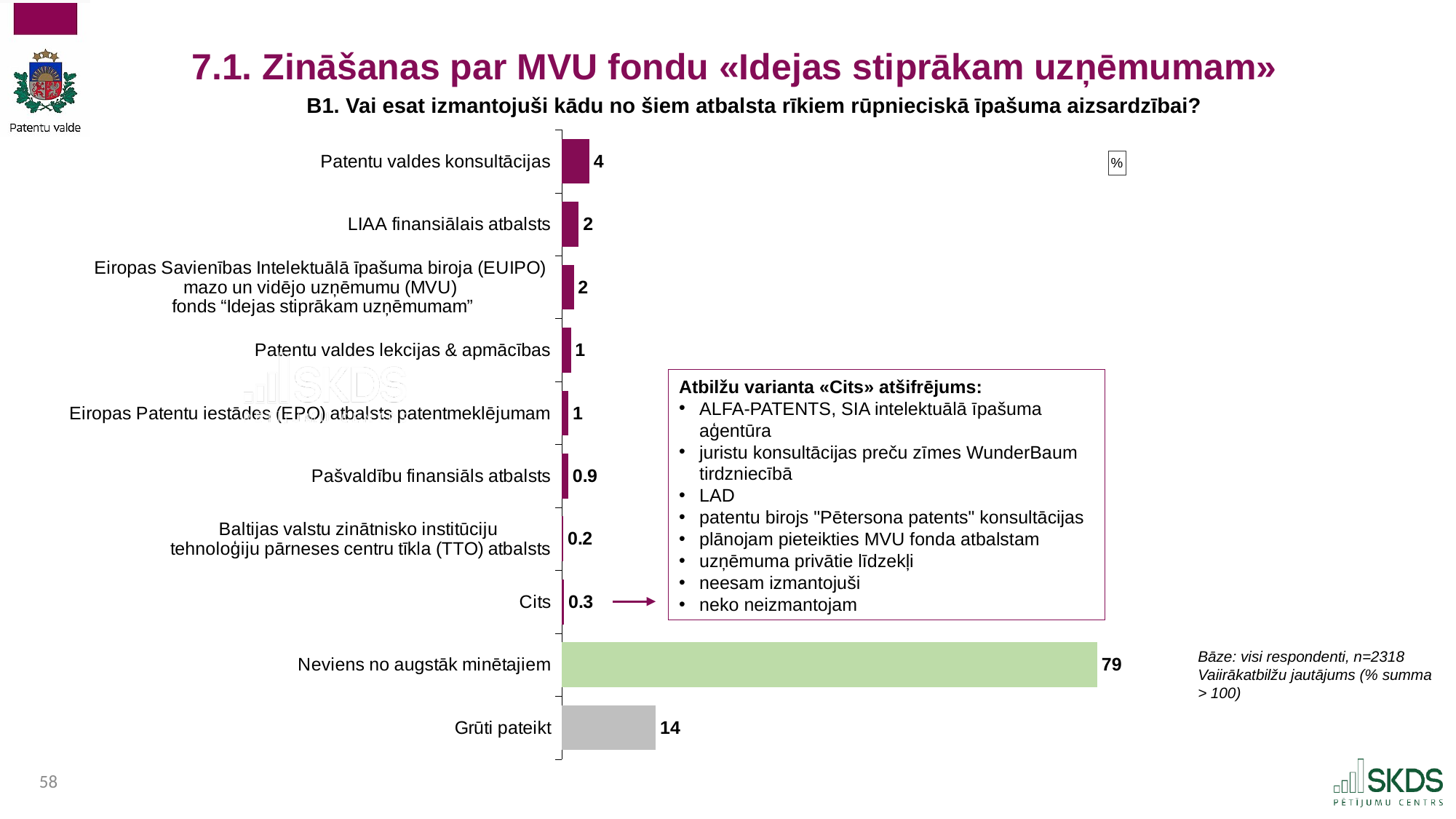
What is the value for "Neviens no augstāk minētajiem"? 79 What is the value for "Grūti pateikt"? 14 What is the difference between the values for "Patentu valdes konsultācijas" and "Patentu valdes lekcijas & apmācības"? 3 What is the value for "Patentu valdes konsultācijas"? 4 What kind of chart is shown on the slide? Bar chart How many categories are shown in the chart? 10 What is the value for "Cits"? 0.3 Which category has the lowest value? Baltijas valstu zinātnisko institūciju tehnoloģiju pārneses centru tīkla (TTO) atbalsts What is the value for "Pašvaldību finansiāls atbalsts"? 0.9 What is the difference between the values for "Neviens no augstāk minētajiem" and "Grūti pateikt"? 65 Which category has the highest value? Neviens no augstāk minētajiem Which is larger: the value for "Patentu valdes konsultācijas" or the value for "LIAA finansiālais atbalsts"? Patentu valdes konsultācijas